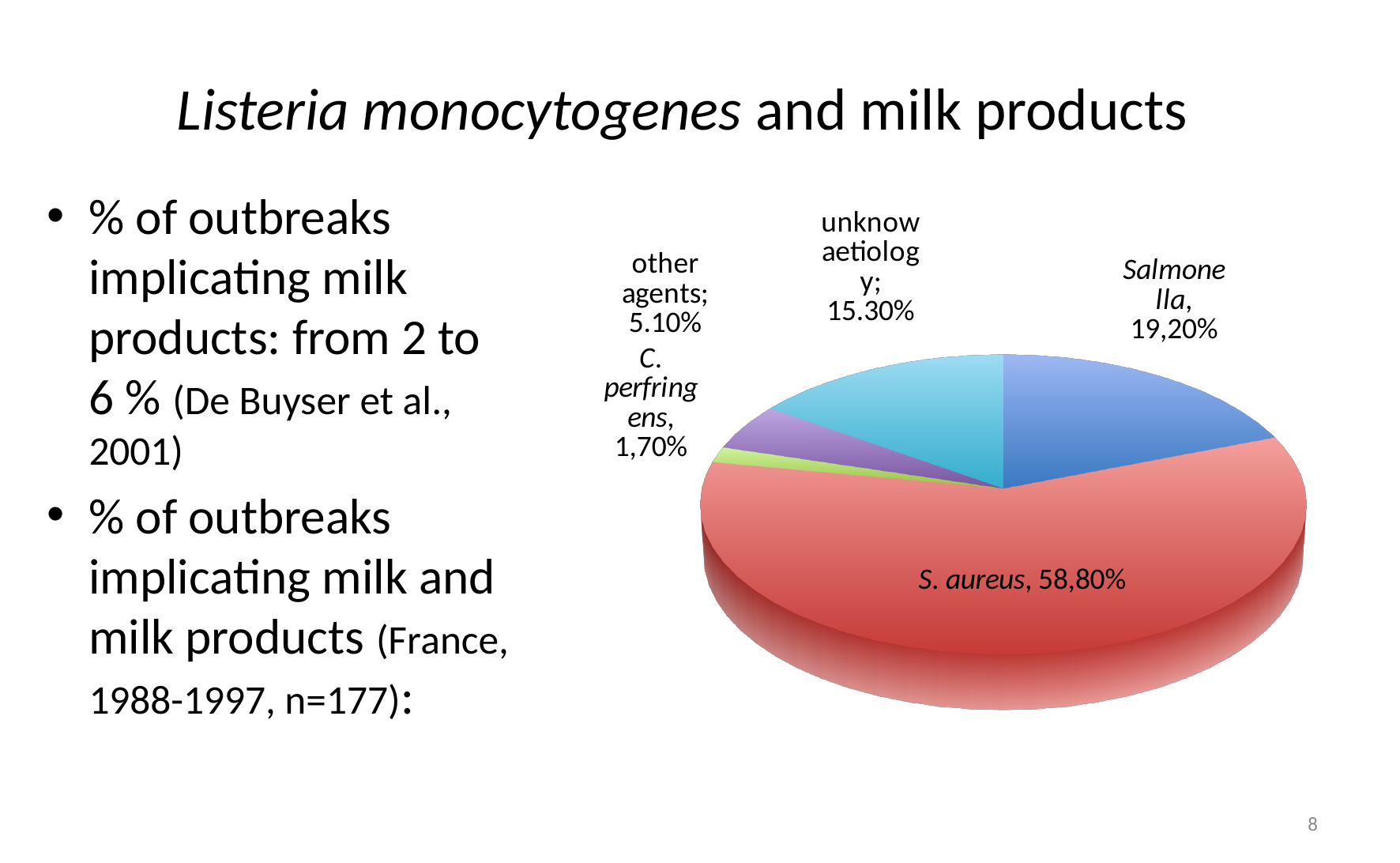
What is the value shown for unknown aetiology in the pie chart? 15.30% What is the value shown for C. perfringens in the pie chart? 1,70% Which slice is larger in the pie chart, Salmonella or unknown aetiology? Salmonella What type of chart is shown on the slide? pie chart Which category has the smallest slice of the pie chart? C. perfringens By how many percentage points does the S. aureus slice exceed the Salmonella slice? 39,60 percentage points What share of the pie chart does Salmonella account for? 19,20% What percentage is shown for other agents in the pie chart? 5.10% How many slices does the pie chart have? 5 What percentage of the pie chart is attributed to S. aureus? 58,80% Which category has the largest slice of the pie chart? S. aureus What colour is the S. aureus slice in the pie chart? red